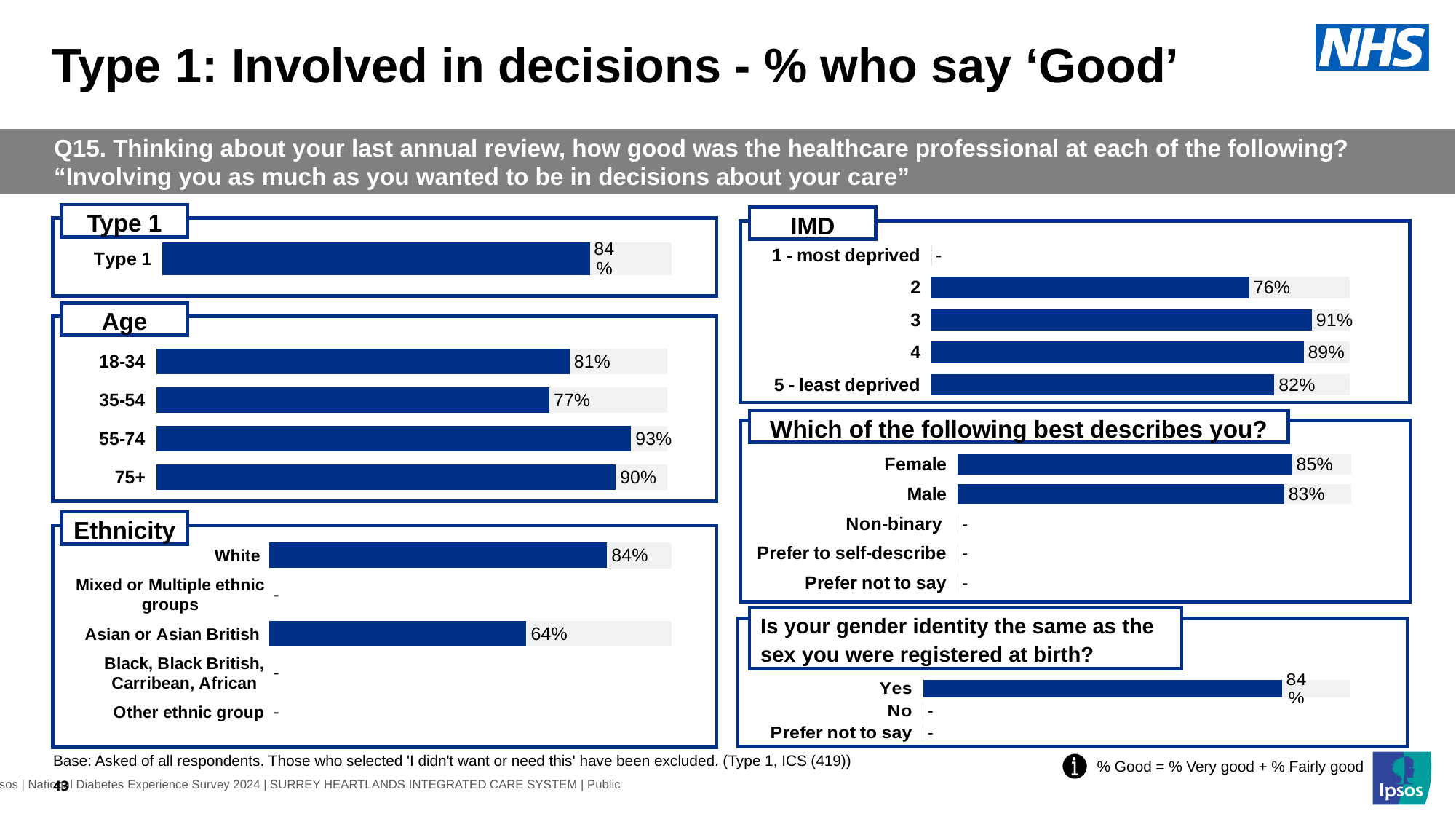
What kind of chart is used in the Age section? Bar chart In the Ethnicity chart, which is larger, the value for White or the value for Asian or Asian British? White In the Age chart, what is the difference between the values for 75+ and 18-34? 9 percentage points In the IMD chart, what is the difference between the values for group 4 and group 5 - least deprived? 7 percentage points In the 'Which of the following best describes you?' chart, what is the value for Female? 85% In the IMD chart, which group has the lowest value among those with a value shown? 2 In the IMD chart, what is the value for IMD group 3? 91% In the Age chart, which age group has the highest value? 55-74 In the Ethnicity chart, what is the value for Asian or Asian British? 64% In the Age chart, what is the value for the 55-74 age group? 93% How many categories are listed in the Ethnicity chart? 5 In the Age chart, which age group has the lowest value? 35-54